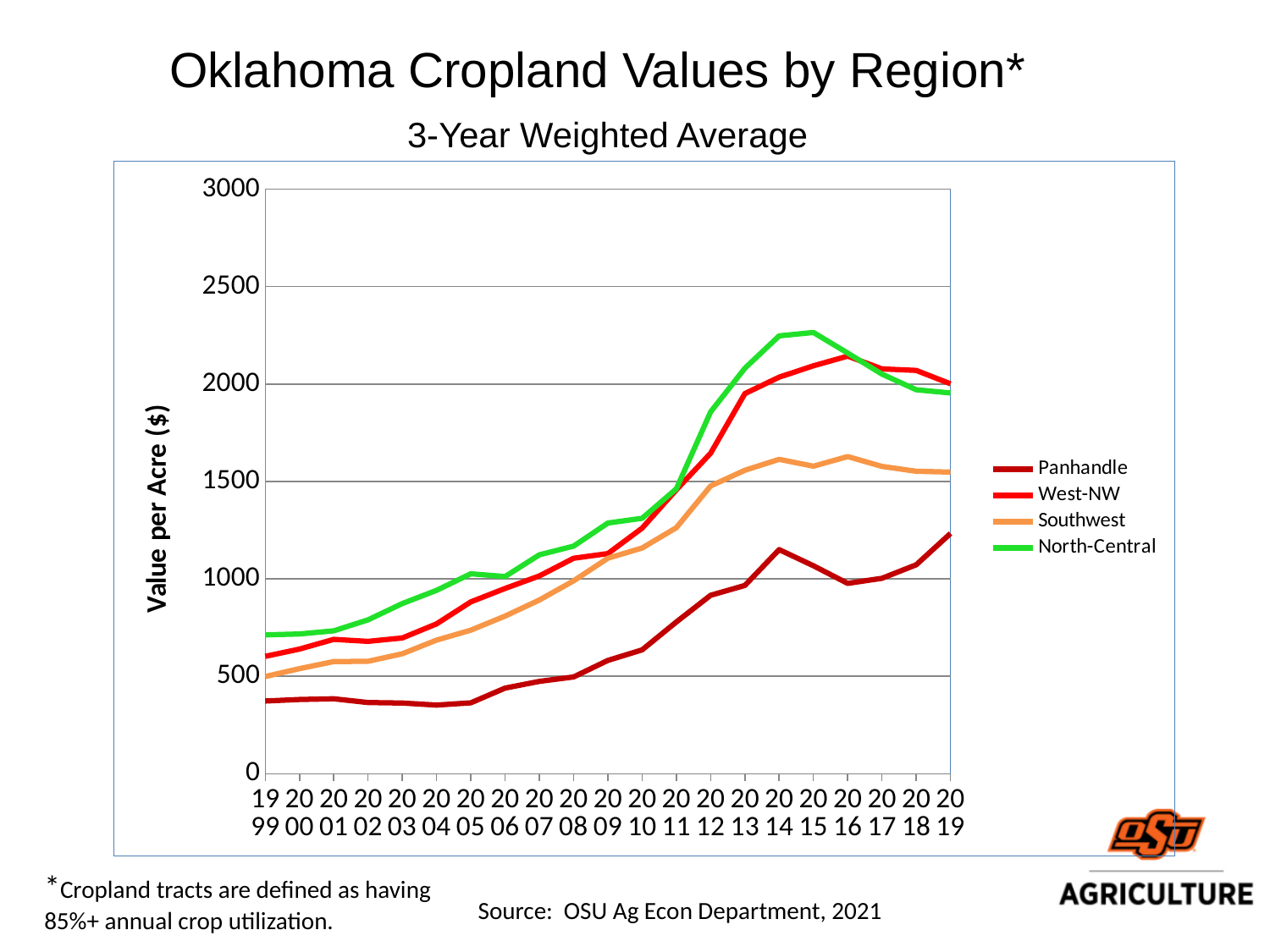
How many series does the legend list? 4 Is the value for North-Central in 2015 greater or less than 2000? greater In 2019, which is larger: the value for Southwest or the value for Panhandle? Southwest Is the value for Panhandle in 1999 greater or less than 500? less How many years are plotted along the x axis? 21 Does the North-Central value rise or fall from 2015 to 2019? fall Is the value for Panhandle in 2019 greater or less than 1000? greater What kind of chart is shown on the slide? line chart Which region has the highest value per acre in 2015? North-Central Which region has the lowest value per acre in 2019? Panhandle What is the label on the y axis? Value per Acre ($)